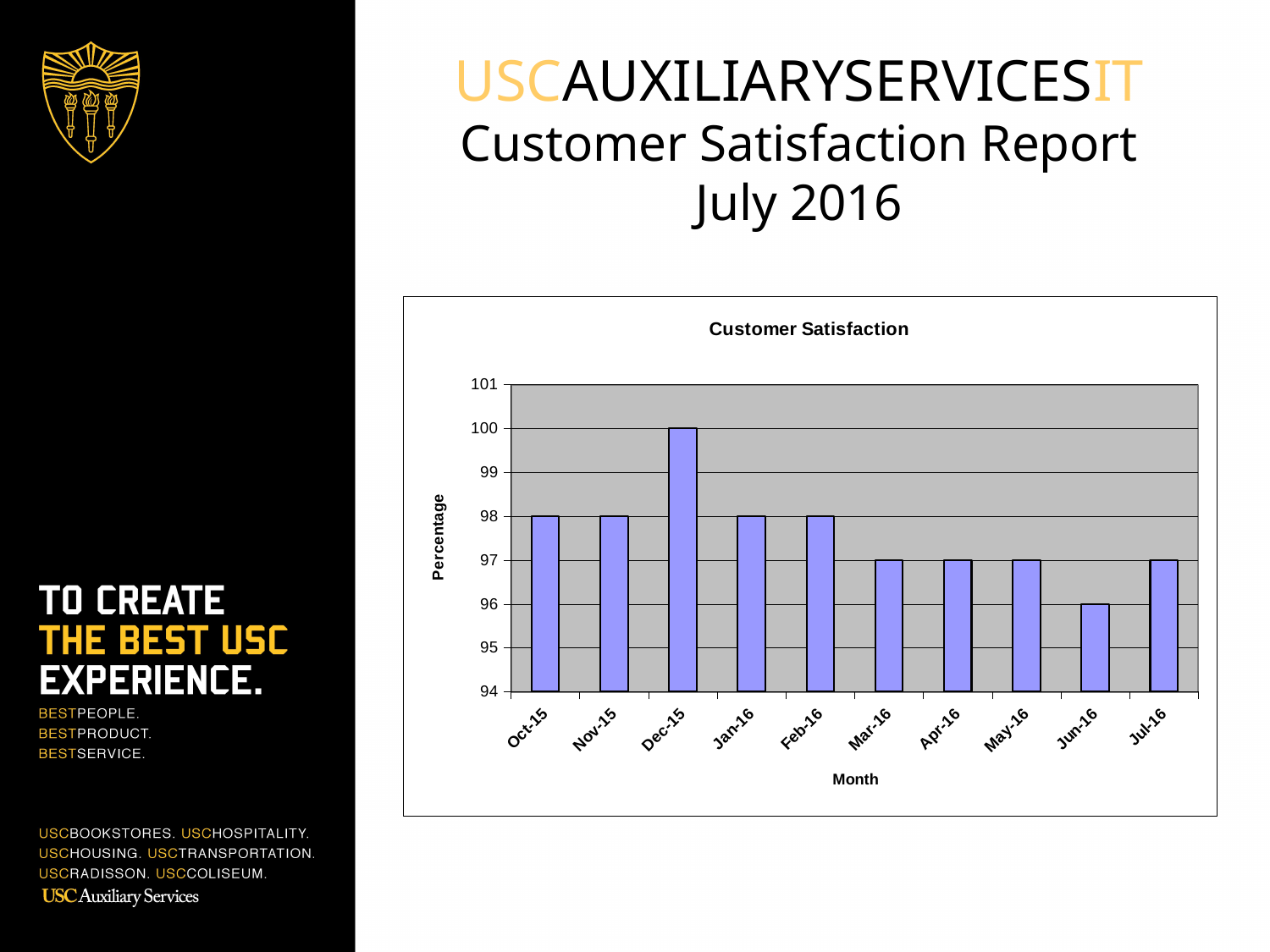
What kind of chart is shown on the slide? Bar chart What is the customer satisfaction percentage for Dec-15? 100 How many months are shown on the x axis of the chart? 10 Which month has a higher customer satisfaction percentage, Feb-16 or Mar-16? Feb-16 Does the customer satisfaction percentage rise or fall from Feb-16 to Mar-16? Fall Which month has the highest customer satisfaction percentage? Dec-15 What is the customer satisfaction percentage for Jun-16? 96 What is the title of the chart? Customer Satisfaction Is the customer satisfaction percentage for Dec-15 greater or less than 99? greater Which month has the lowest customer satisfaction percentage? Jun-16 What is the difference between the customer satisfaction percentage for Dec-15 and Jun-16? 4 What is the customer satisfaction percentage for Jul-16? 97